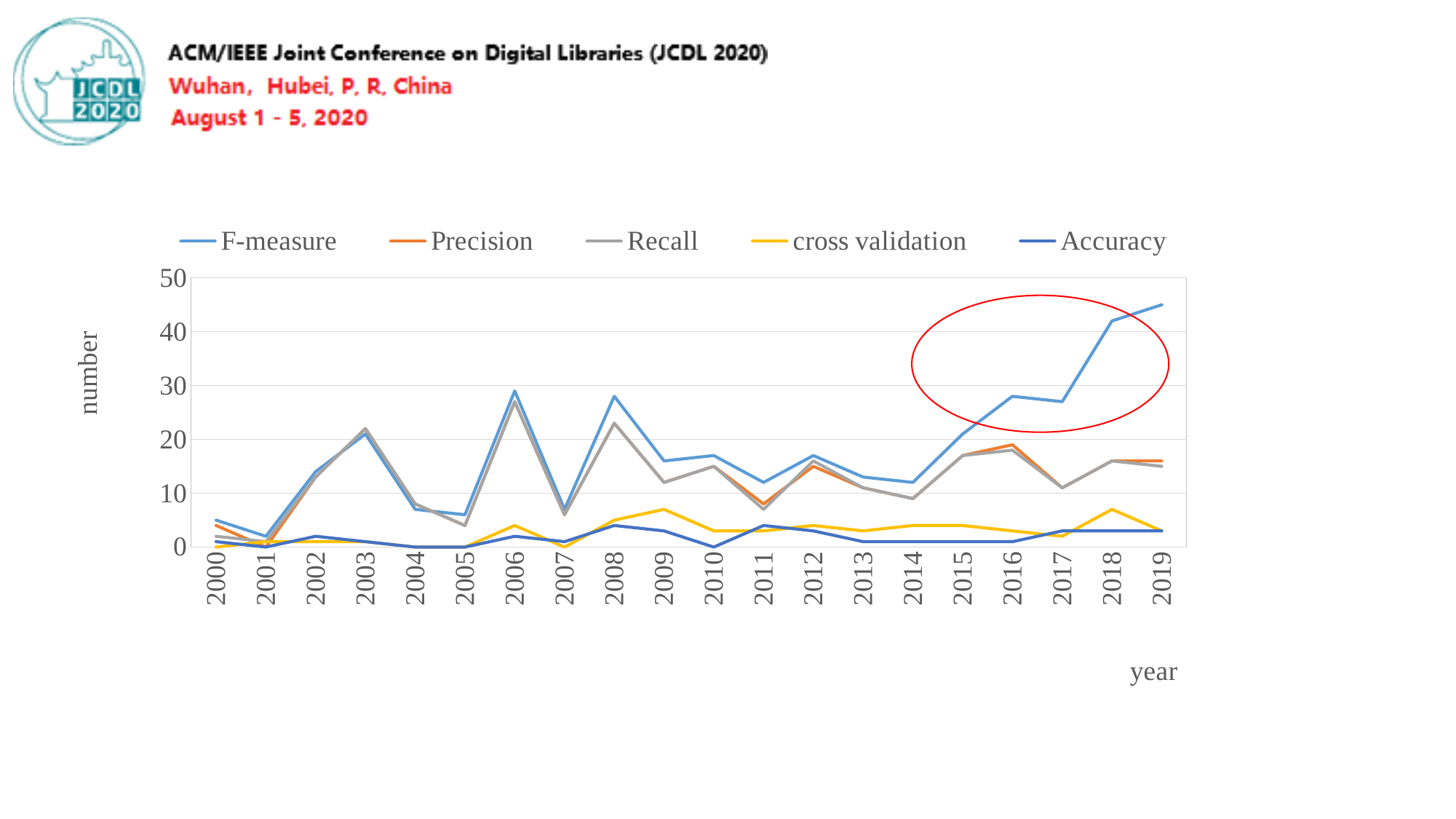
How many series does the legend list? 5 In which year is the F-measure series at its lowest value? 2001 Is the value for Accuracy in 2010 greater or less than 10? less In which year does the F-measure series reach its highest value? 2019 Which series has the larger value in 2019, F-measure or Accuracy? F-measure Which year has the larger Recall value, 2006 or 2007? 2006 Is the value for F-measure in 2006 greater or less than 20? greater Is the value for F-measure in 2019 greater or less than 40? greater What is the label on the y axis of the chart? number Does the F-measure series rise or fall from 2014 to 2019? rise What kind of chart is shown on the slide? line chart How many years are shown along the x axis? 20